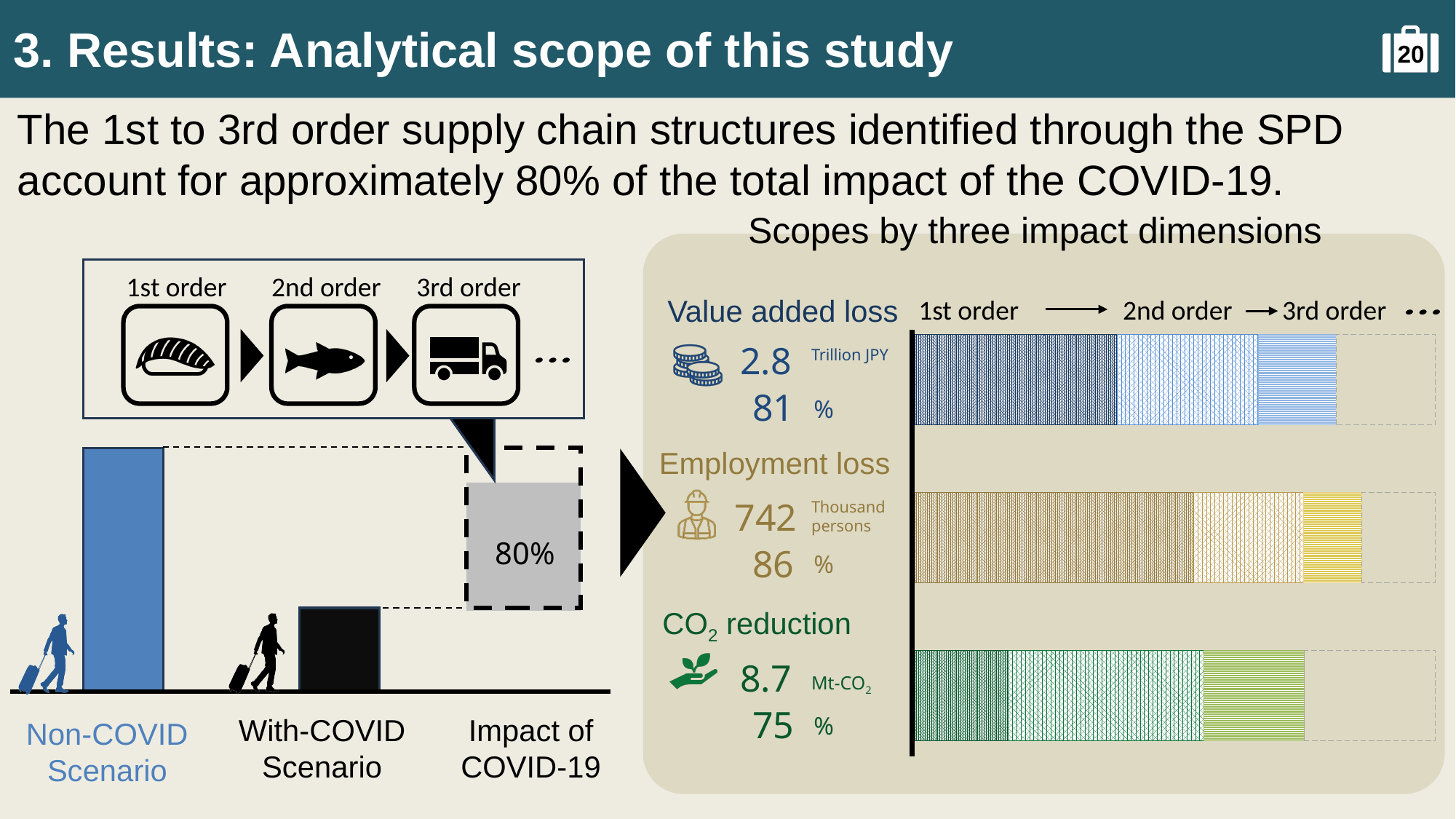
In the 'Scopes by three impact dimensions' chart, what percentage is shown for CO2 reduction? 75 % In the 'Scopes by three impact dimensions' chart, how many impact dimensions (bars) are shown? 3 In the 'Scopes by three impact dimensions' chart, what is the Employment loss in thousand persons? 742 Thousand persons In the 'Scopes by three impact dimensions' chart, what is the Value added loss in Trillion JPY? 2.8 Trillion JPY In the 'Scopes by three impact dimensions' chart, which impact dimension has the highest percentage? Employment loss In the chart on the left of the slide, which scenario has the taller bar, Non-COVID Scenario or With-COVID Scenario? Non-COVID Scenario In the 'Scopes by three impact dimensions' chart, what percentage is shown for Employment loss? 86 % In the 'Scopes by three impact dimensions' chart, which impact dimension has the lowest percentage? CO2 reduction In the 'Scopes by three impact dimensions' chart, what is the difference in percentage between Employment loss and CO2 reduction? 11 % In the 'Scopes by three impact dimensions' chart, what percentage is shown for Value added loss? 81 % In the chart on the left of the slide, what percentage is shown in the grey box for the Impact of COVID-19? 80% In the 'Scopes by three impact dimensions' chart, what is the CO2 reduction in Mt-CO2? 8.7 Mt-CO2